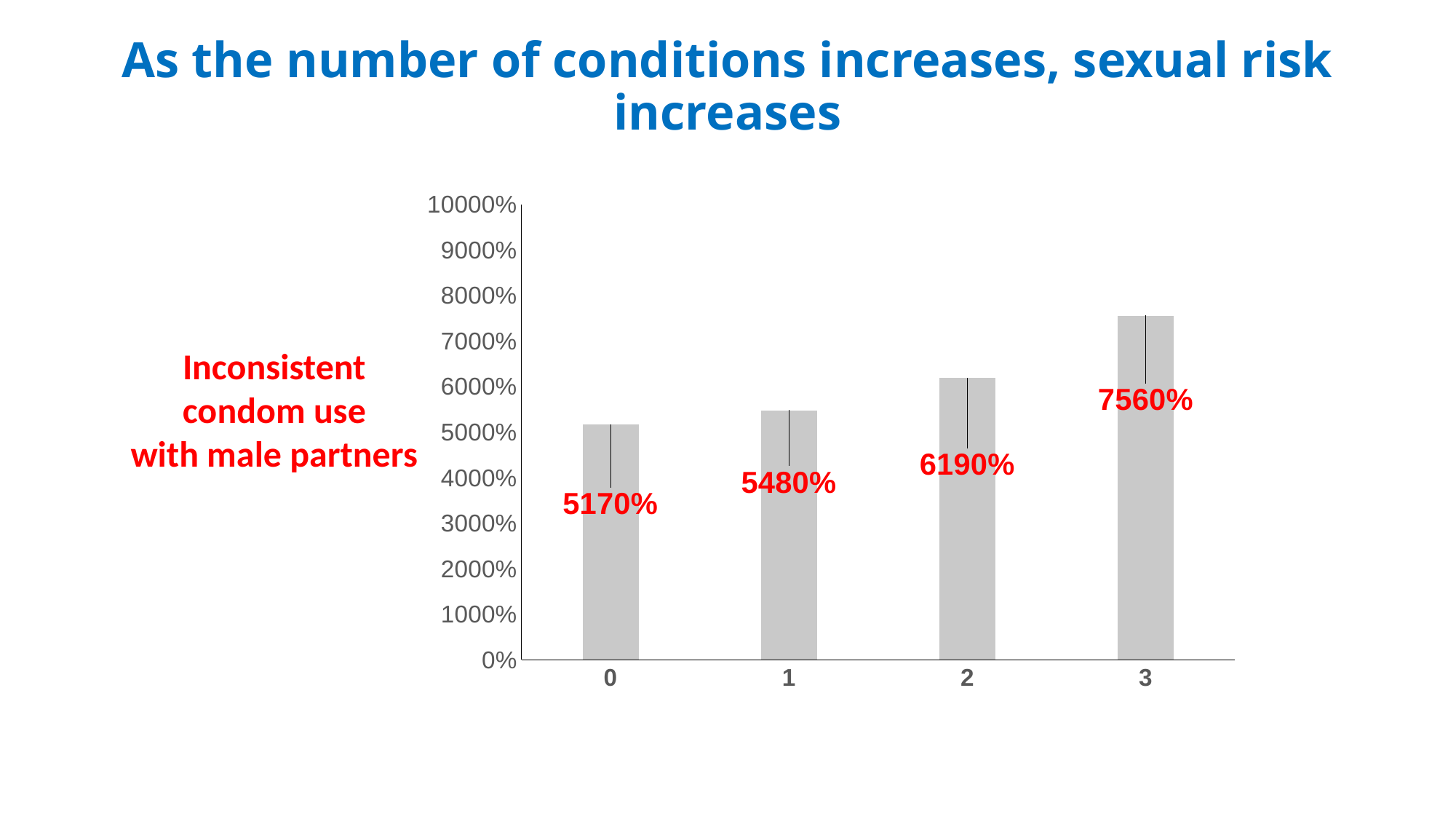
What is the value for category 2? 6190% Which is larger, the value for category 1 or the value for category 2? category 2 What is the value for category 3? 7560% What kind of chart is shown on the slide? bar chart Which category has the lowest value? 0 What is the difference between the values for category 3 and category 0? 2390% Which category has the highest value? 3 What is the difference between the values for category 2 and category 1? 710% What is the value for category 1? 5480% What is the value for category 0? 5170% Do the values rise or fall as the category number increases from 0 to 3? rise How many categories are shown on the x axis? 4